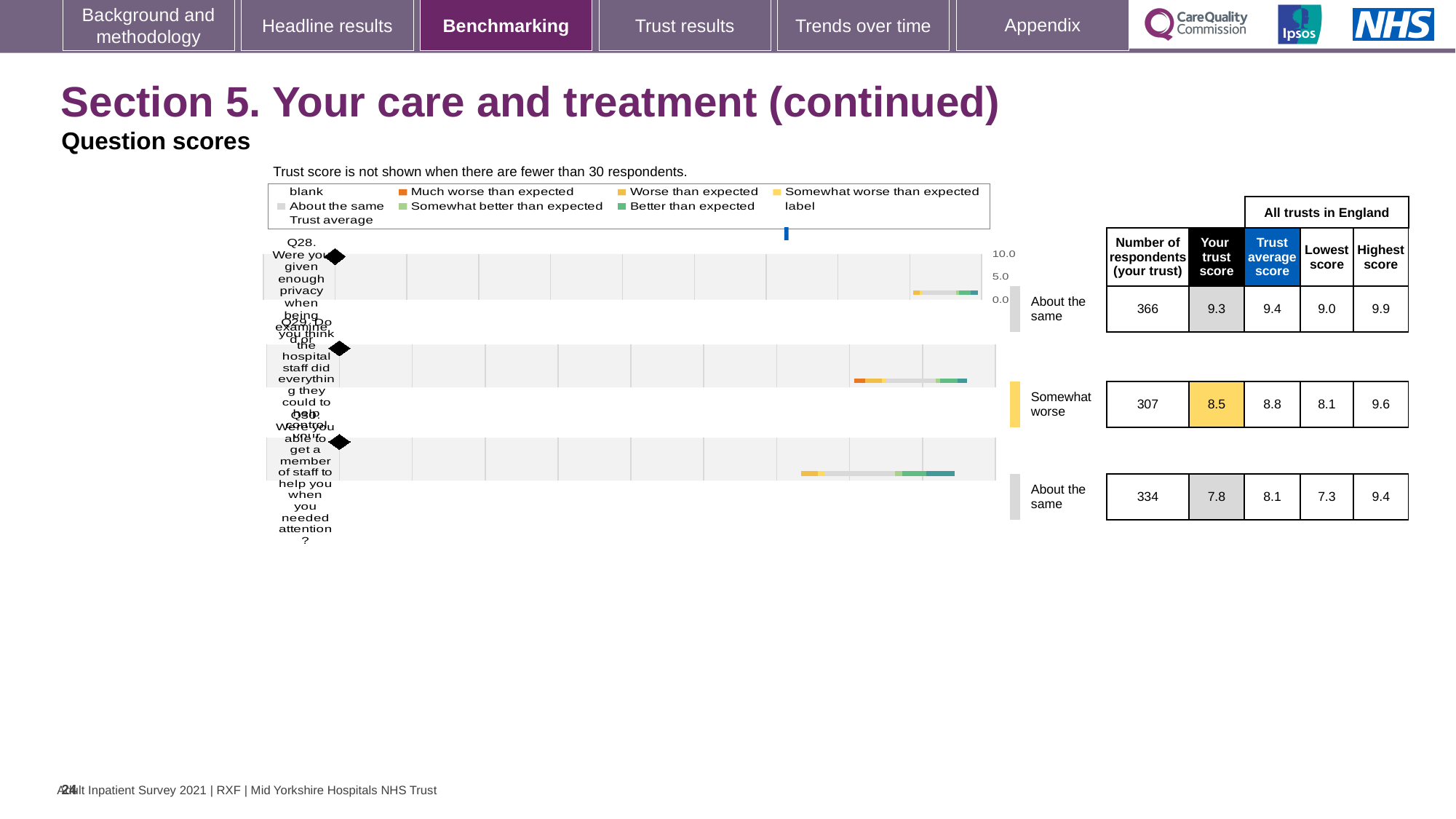
Which question has the highest trust score on this slide? Q28 What is the maximum value shown on the score axis of the charts? 10.0 How many questions (Q28, Q29, Q30) are plotted on the slide? 3 Which question has the lowest trust score on this slide? Q30 How many respondents answered Q29 at this trust? 307 What kind of chart is used to show the question scores on this slide? bar chart What is the trust score for Q28 (Were you given enough privacy when being examined or treated)? 9.3 For Q29, which is larger: the trust score or the trust average score? Trust average score (8.8) What is the highest score across all trusts in England for Q30? 9.4 What is the trust score for Q29 (Do you think the hospital staff did everything they could to help control your pain)? 8.5 What is the trust score for Q30 (Were you able to get a member of staff to help you when you needed attention)? 7.8 What is the difference between the trust average score and the trust score for Q28? 0.1